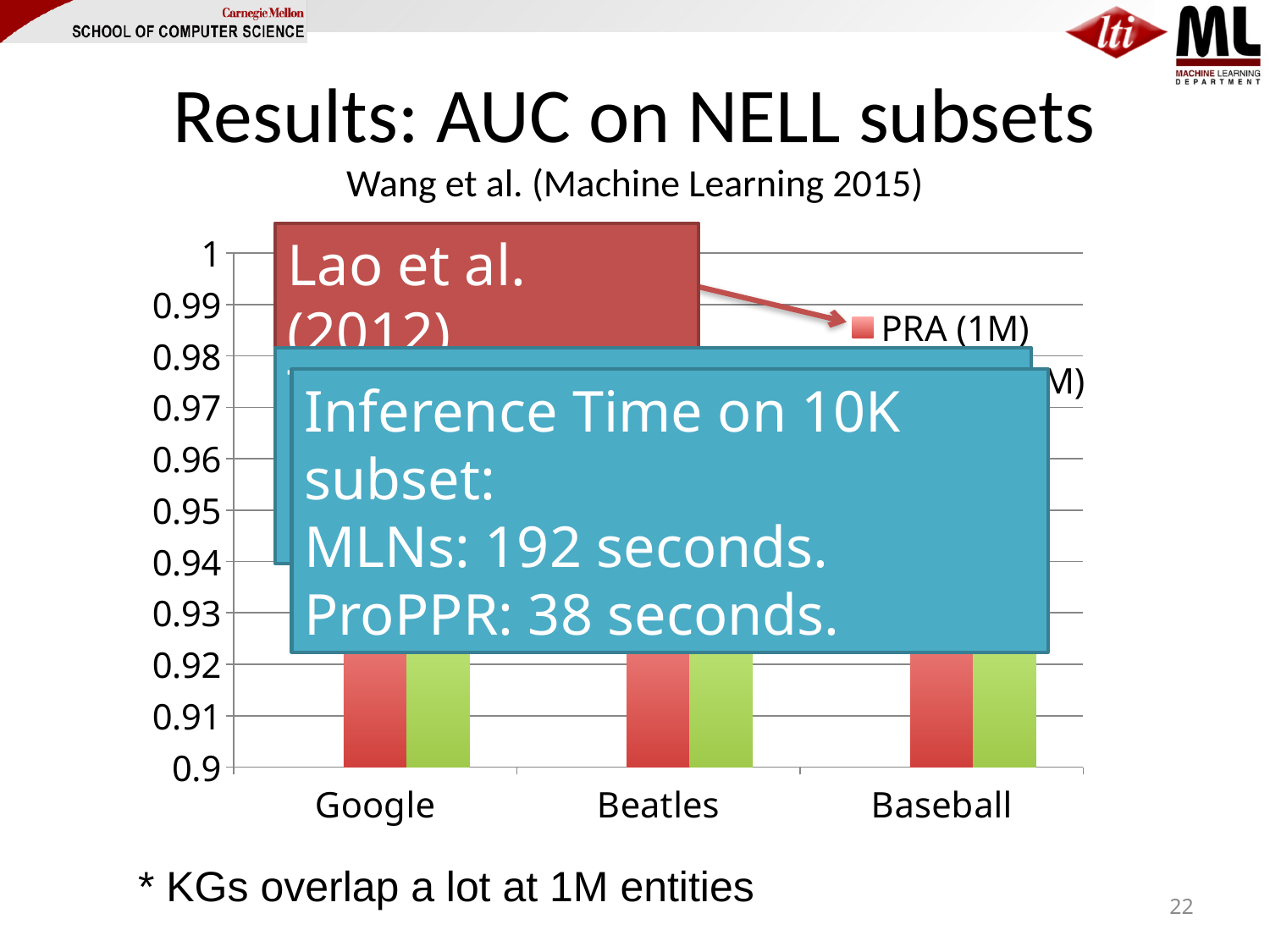
Is the value of the red bar for Beatles greater or less than 0.9? greater Is the value of the green bar for Baseball greater or less than 0.92? greater What is the title of the chart on the slide? Results: AUC on NELL subsets Is the value of the red bar for Google greater or less than 0.91? greater What is the lowest value shown on the y axis of the chart? 0.9 How many bars are plotted for each category in the chart? 2 How many categories are shown on the x axis of the chart? 3 What kind of chart is shown on the slide? bar chart What are the category labels on the x axis of the chart? Google, Beatles, Baseball